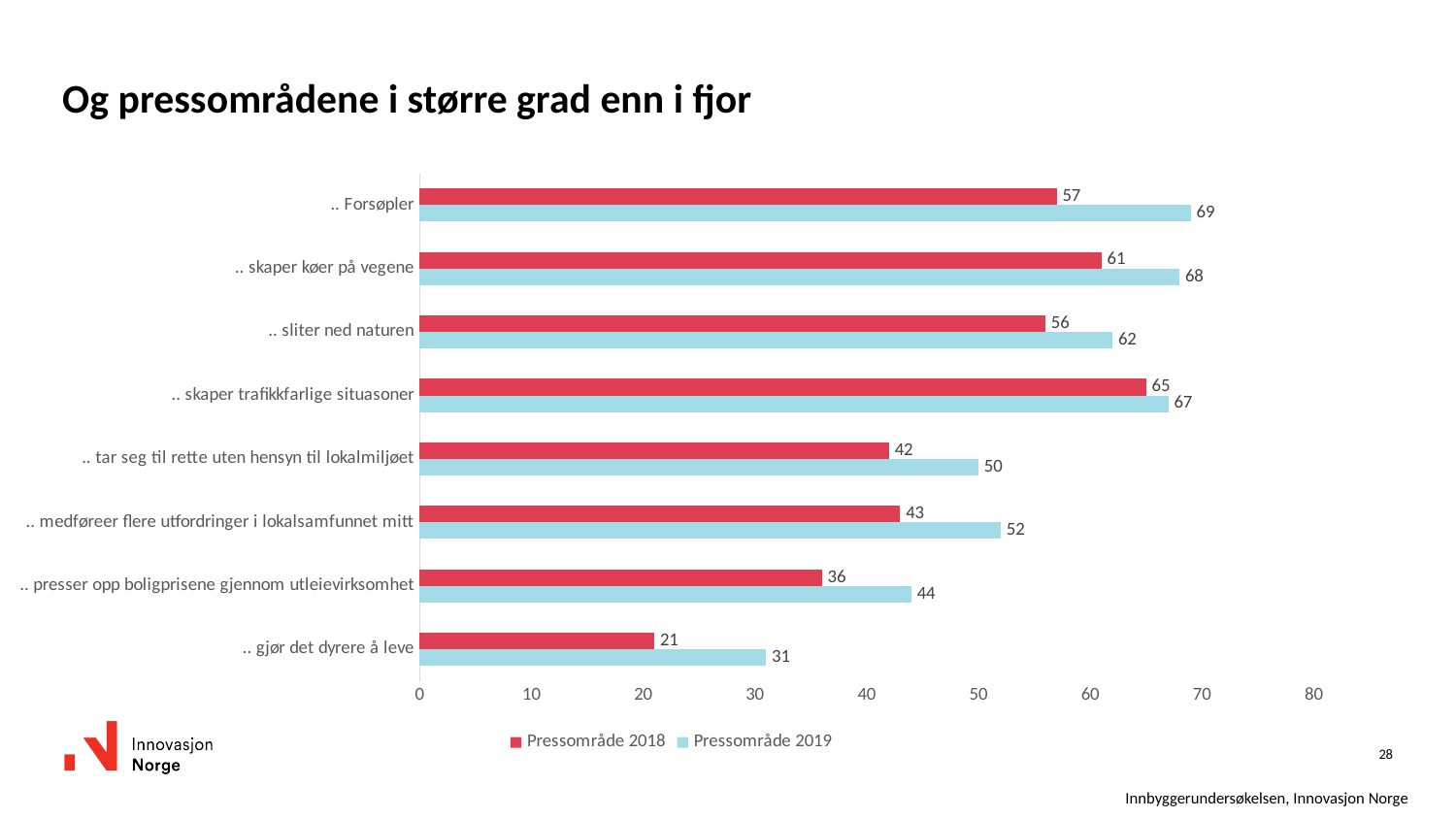
What is the difference between the Pressområde 2019 and Pressområde 2018 values for ".. gjør det dyrere å leve"? 10 What is the difference between the Pressområde 2019 and Pressområde 2018 values for ".. Forsøpler"? 12 How many series does the legend list? 2 What is the title of the slide? Og pressområdene i større grad enn i fjor What is the value for ".. gjør det dyrere å leve" in the Pressområde 2019 series? 31 How many categories are shown on the chart? 8 What is the value for ".. skaper køer på vegene" in the Pressområde 2018 series? 61 What kind of chart is shown on the slide? Bar chart Which is larger for ".. presser opp boligprisene gjennom utleievirksomhet": the Pressområde 2018 value or the Pressområde 2019 value? Pressområde 2019 What is the value for ".. Forsøpler" in the Pressområde 2019 series? 69 Which category has the highest value in the Pressområde 2018 series? .. skaper trafikkfarlige situasoner Which category has the lowest value in the Pressområde 2019 series? .. gjør det dyrere å leve